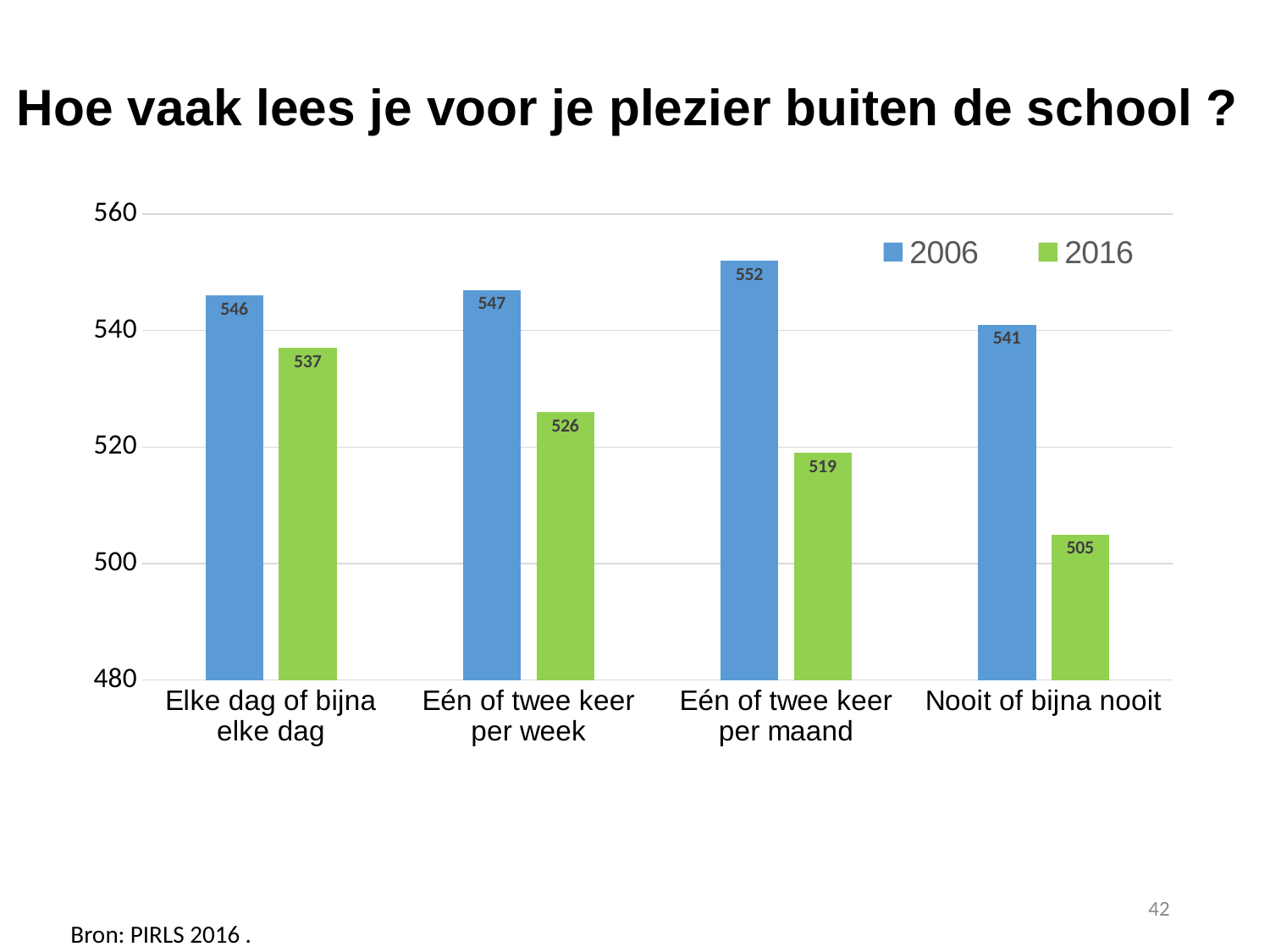
Which category has the lowest 2016 value? Nooit of bijna nooit What is the 2016 value for 'Nooit of bijna nooit'? 505 What kind of chart is shown on the slide? Bar chart What is the 2016 value for 'Elke dag of bijna elke dag'? 537 What is the difference between the 2006 and 2016 values for 'Eén of twee keer per week'? 21 Which is larger: the 2016 value for 'Elke dag of bijna elke dag' or the 2016 value for 'Eén of twee keer per week'? Elke dag of bijna elke dag How many categories are shown on the x axis? 4 What is the difference between the 2006 and 2016 values for 'Nooit of bijna nooit'? 36 How many series does the legend list? 2 Do the 2016 values rise or fall from left to right along the x axis? Fall Which category has the highest 2006 value? Eén of twee keer per maand What is the 2006 value for 'Eén of twee keer per maand'? 552